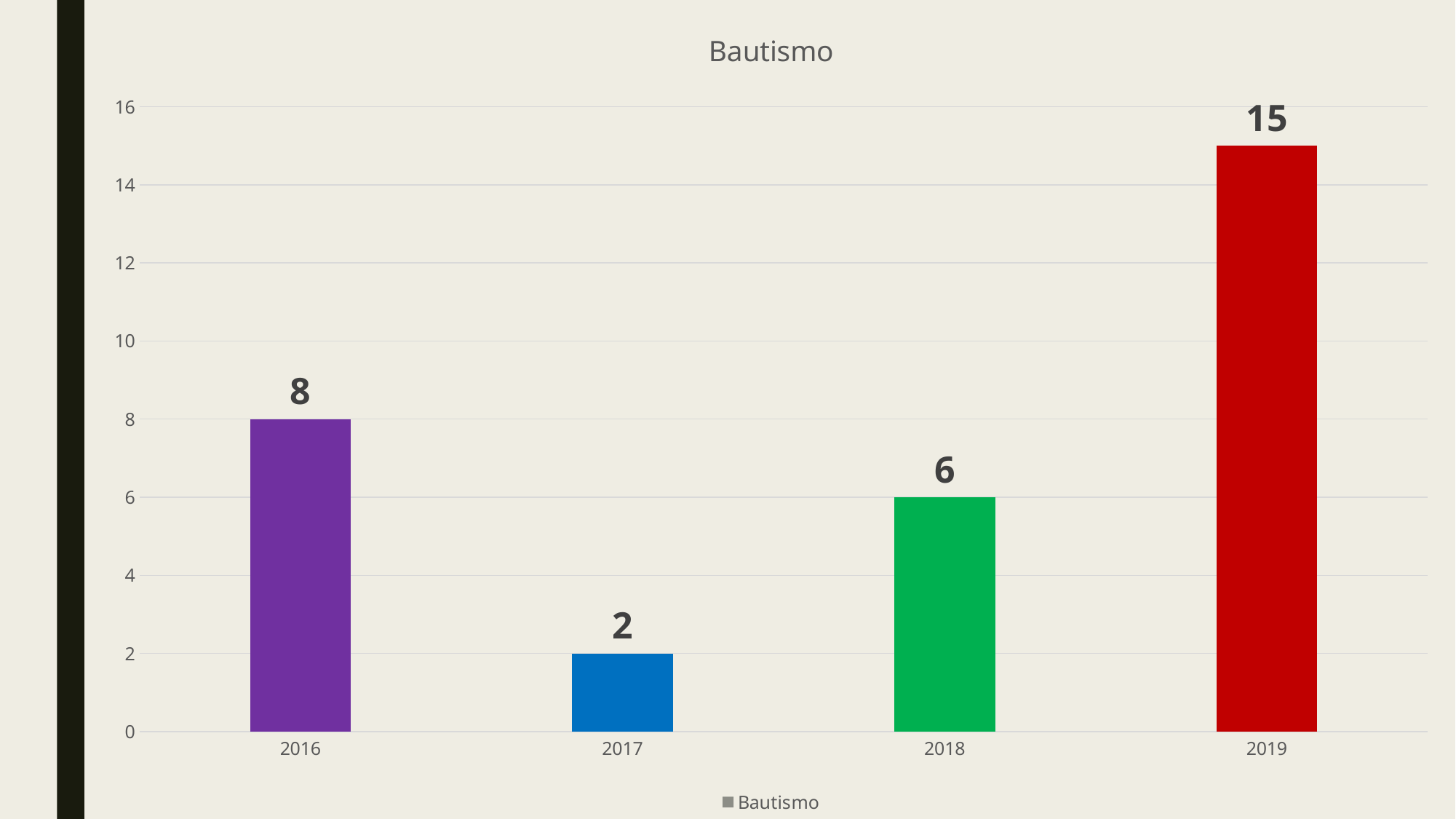
How many years are shown on the x axis? 4 What kind of chart is shown? bar chart What is the value for 2019? 15 What is the value for 2018? 6 Which year has the highest value? 2019 What is the value for 2016? 8 What is the value for 2017? 2 Which year has the lowest value? 2017 Which is larger, the value for 2016 or the value for 2018? 2016 What is the difference between the values for 2019 and 2016? 7 What is the title of the chart? Bautismo Is the value for 2019 greater or less than 14? greater